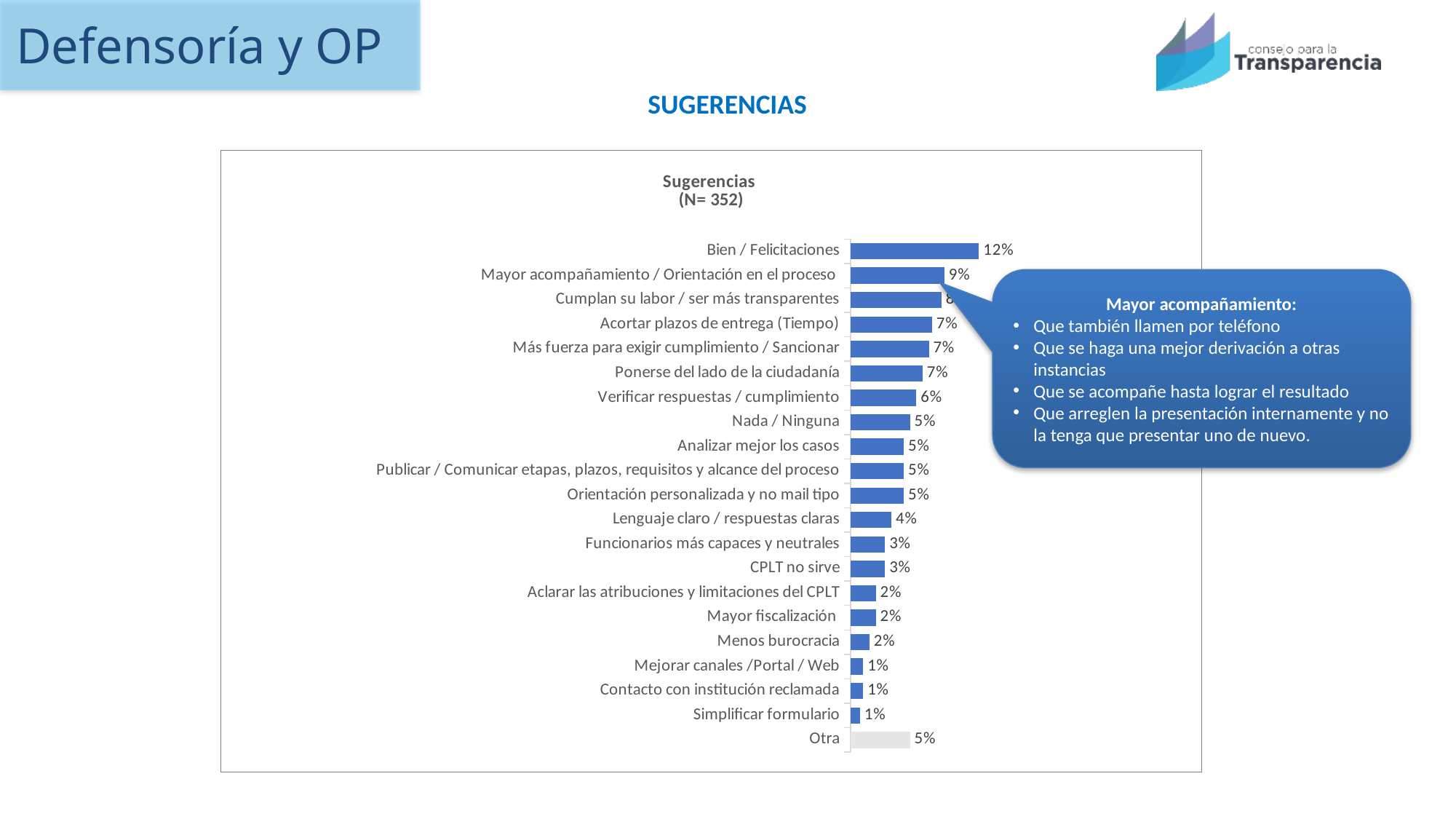
What is the value for Verificar respuestas / cumplimiento? 6% Which is larger, the value for Acortar plazos de entrega (Tiempo) or the value for Funcionarios más capaces y neutrales? Acortar plazos de entrega (Tiempo) What is the difference between the values for Nada / Ninguna and Simplificar formulario? 4% What is the sample size (N) stated in the chart title? 352 Which category has the highest value? Bien / Felicitaciones What is the value for Lenguaje claro / respuestas claras? 4% What is the difference between the values for Bien / Felicitaciones and Mayor acompañamiento / Orientación en el proceso? 3% How many categories are shown in the chart? 21 What is the value for Bien / Felicitaciones? 12% What is the value for Mayor acompañamiento / Orientación en el proceso? 9% What is the value for Otra? 5% What kind of chart is shown on the slide? Bar chart